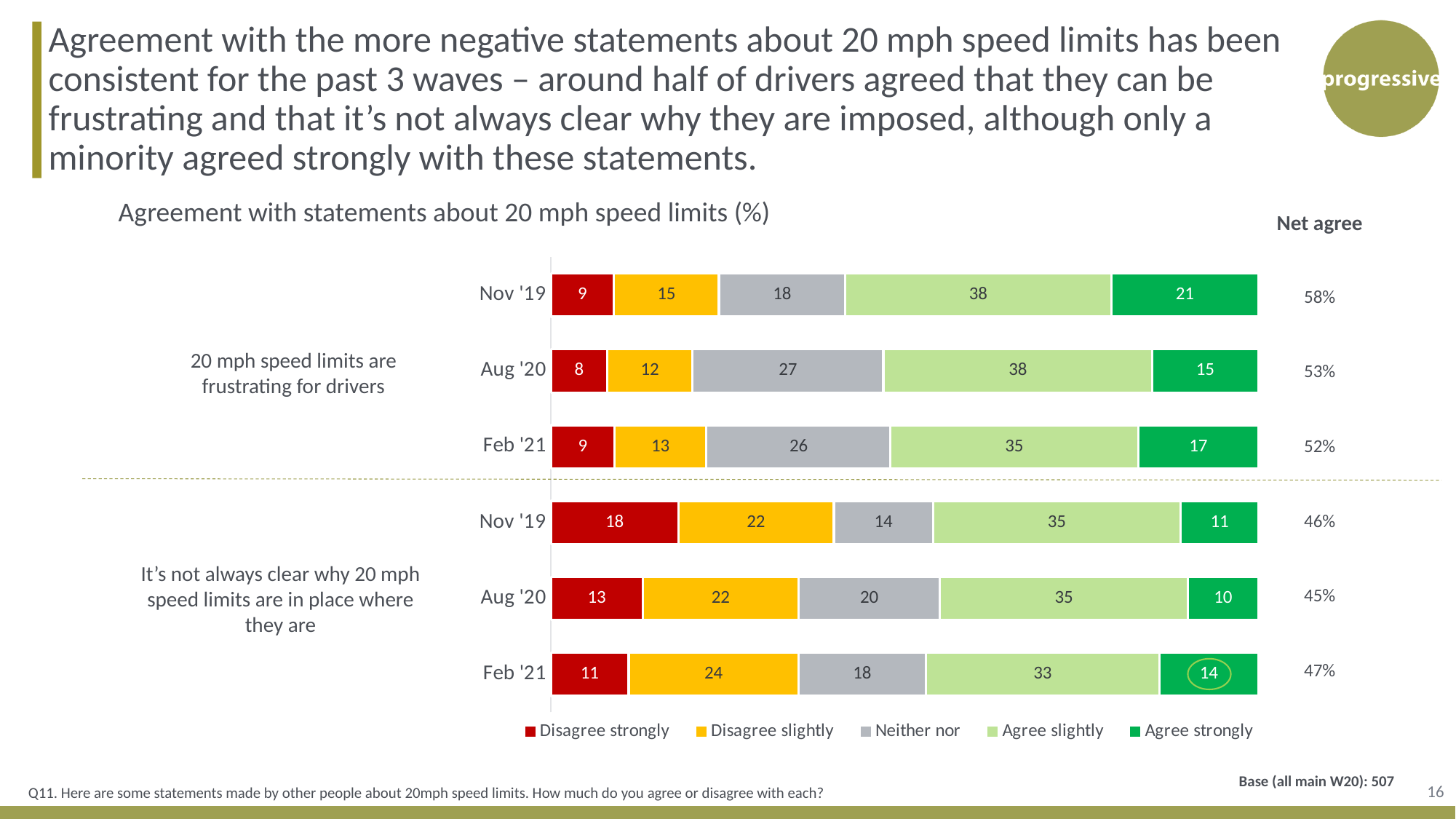
How many series does the legend list? 5 For Feb '21, which is larger: the 'Neither nor' value for '20 mph speed limits are frustrating for drivers' or for 'It's not always clear why 20 mph speed limits are in place where they are'? 20 mph speed limits are frustrating for drivers Which wave has the highest 'Disagree strongly' value for the statement 'It's not always clear why 20 mph speed limits are in place where they are'? Nov '19 Which wave has the lowest 'Agree strongly' value for the statement 'It's not always clear why 20 mph speed limits are in place where they are'? Aug '20 What is the title of the chart? Agreement with statements about 20 mph speed limits (%) What is the net agree figure for Nov '19 on the statement '20 mph speed limits are frustrating for drivers'? 58% What percentage of drivers agreed strongly in Nov '19 that 20 mph speed limits are frustrating for drivers? 21 What kind of chart is shown on the slide? Stacked bar chart How many bars are plotted in the chart? 6 What is the difference between the 'Agree slightly' values for Nov '19 and Feb '21 on the statement '20 mph speed limits are frustrating for drivers'? 3 What is the 'Disagree slightly' value for Feb '21 on the statement 'It's not always clear why 20 mph speed limits are in place where they are'? 24 What is the 'Neither nor' value for Aug '20 on the statement '20 mph speed limits are frustrating for drivers'? 27